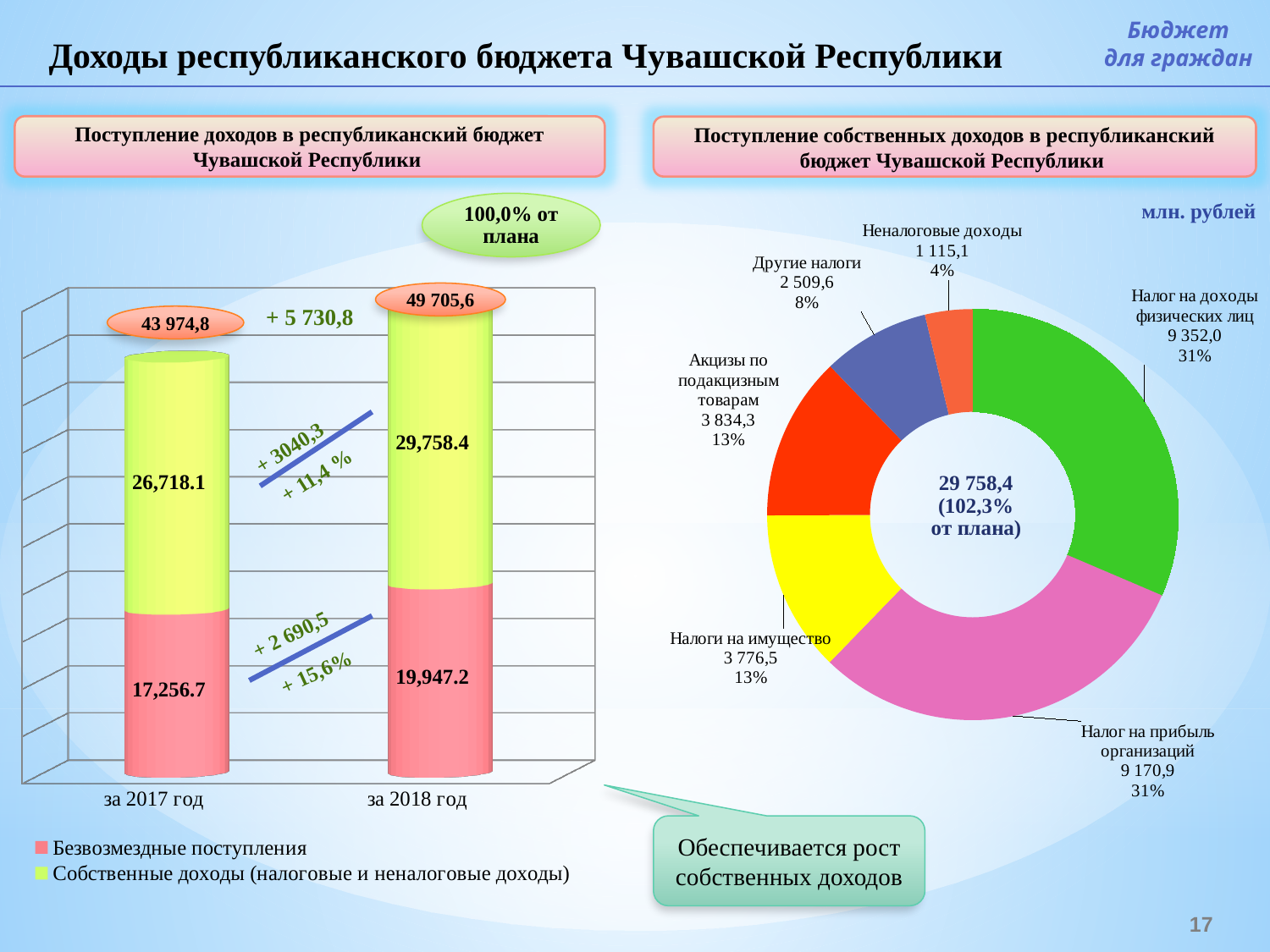
On the left chart, by how much did Собственные доходы increase from 2017 to 2018? 3,040.3 On the left chart, what is the value of Безвозмездные поступления for 2017? 17,256.7 On the left chart, what is the total of the stacked bar for 2018? 49 705,6 On the right chart (Поступление собственных доходов в республиканский бюджет Чувашской Республики), what is the value for Акцизы по подакцизным товарам? 3 834,3 On the right chart, what share does Налог на прибыль организаций have? 31% On the right chart, which category has the smallest value? Неналоговые доходы On the left chart (Поступление доходов в республиканский бюджет Чувашской Республики), what is the value of Собственные доходы for 2018? 29,758.4 On the right chart, which is larger: Налоги на имущество or Другие налоги? Налоги на имущество What kind of chart is the left chart? stacked bar chart On the right chart, how many slices are there? 6 On the left chart, do Безвозмездные поступления rise or fall from 2017 to 2018? rise On the left chart, how many series does the legend list? 2